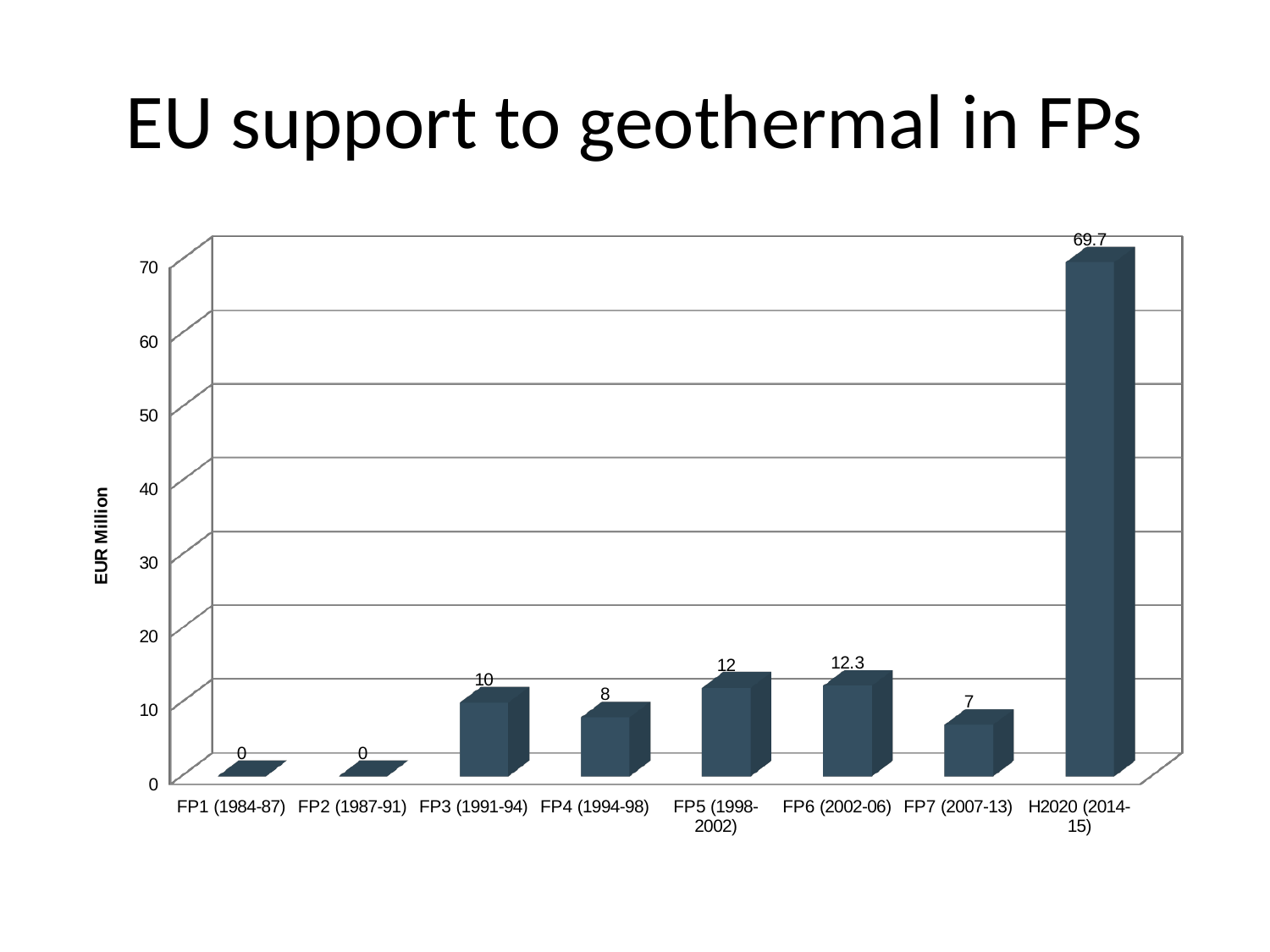
Which category has the highest value? H2020 (2014-15) What is the value for FP7 (2007-13)? 7 What is the label of the vertical axis? EUR Million What kind of chart is shown on the slide? Bar chart What is the difference between the values for FP5 (1998-2002) and FP4 (1994-98)? 4 What is the value for H2020 (2014-15)? 69.7 What is the difference between the values for H2020 (2014-15) and FP7 (2007-13)? 62.7 What is the value for FP6 (2002-06)? 12.3 How many categories have a value of 0? 2 Which is larger, the value for FP3 (1991-94) or the value for FP4 (1994-98)? FP3 (1991-94) How many categories are shown on the x axis? 8 What is the value for FP3 (1991-94)? 10